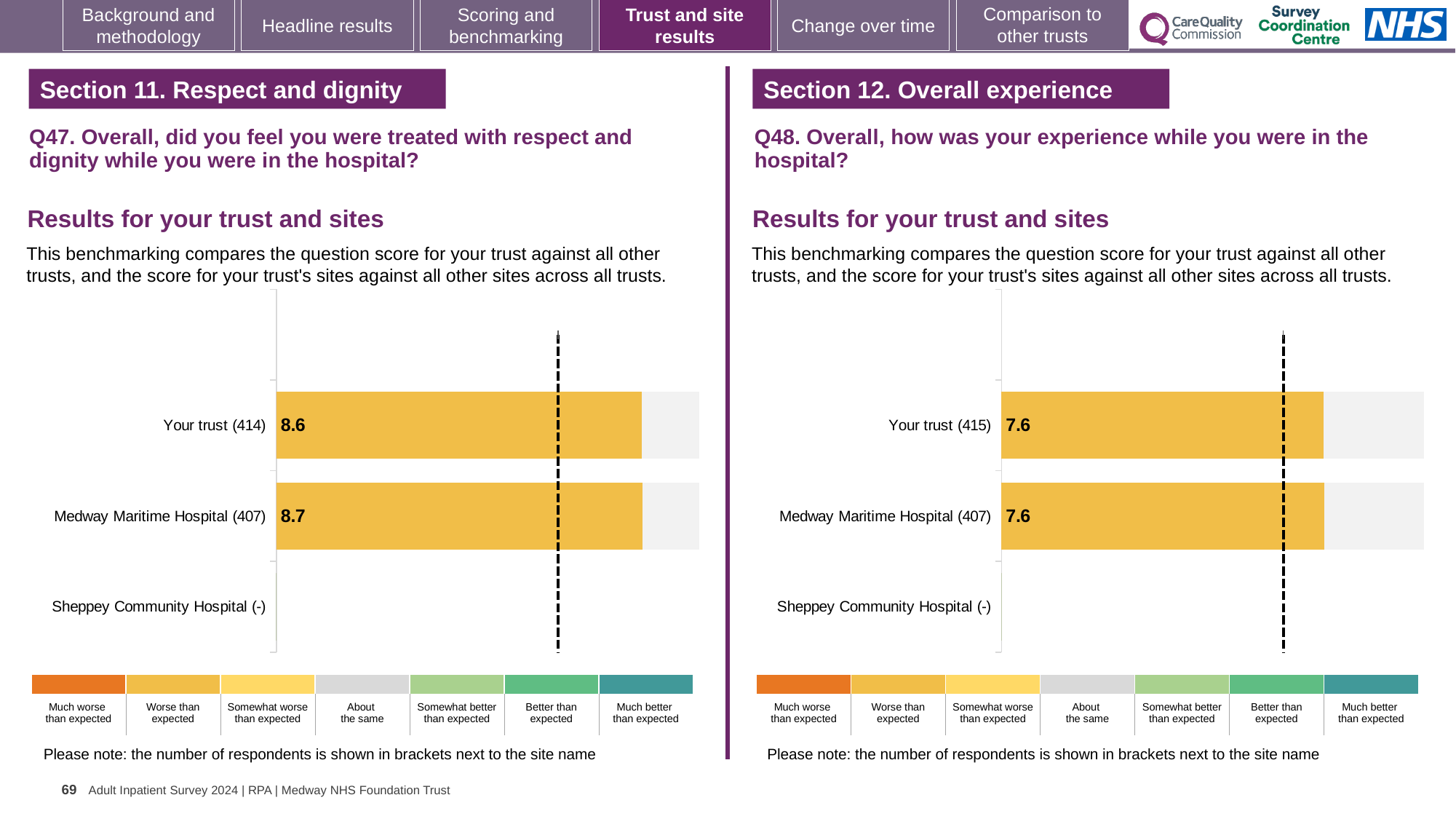
In the Q47 chart on the left, how many respondents are shown in brackets for Your trust? 414 In the Q47 chart on the left, which site has no score shown (marked with a dash)? Sheppey Community Hospital How many site/trust rows are listed in the Q48 chart on the right? 3 How many categories does the colour legend below the Q48 chart on the right list? 7 What kind of chart is used in the Q47 chart on the left? Bar chart In the Q47 chart on the left, which has the higher score, Your trust or Medway Maritime Hospital? Medway Maritime Hospital In the Q47 chart on the left, what is the score for Your trust? 8.6 In the Q47 chart on the left, what is the difference between the Medway Maritime Hospital score and the Your trust score? 0.1 In the Q47 chart on the left, what is the score for Medway Maritime Hospital? 8.7 In the Q48 chart on the right, what is the score for Your trust? 7.6 In the Q48 chart on the right, how many respondents are shown in brackets for Your trust? 415 In the Q48 chart on the right, what is the score for Medway Maritime Hospital? 7.6